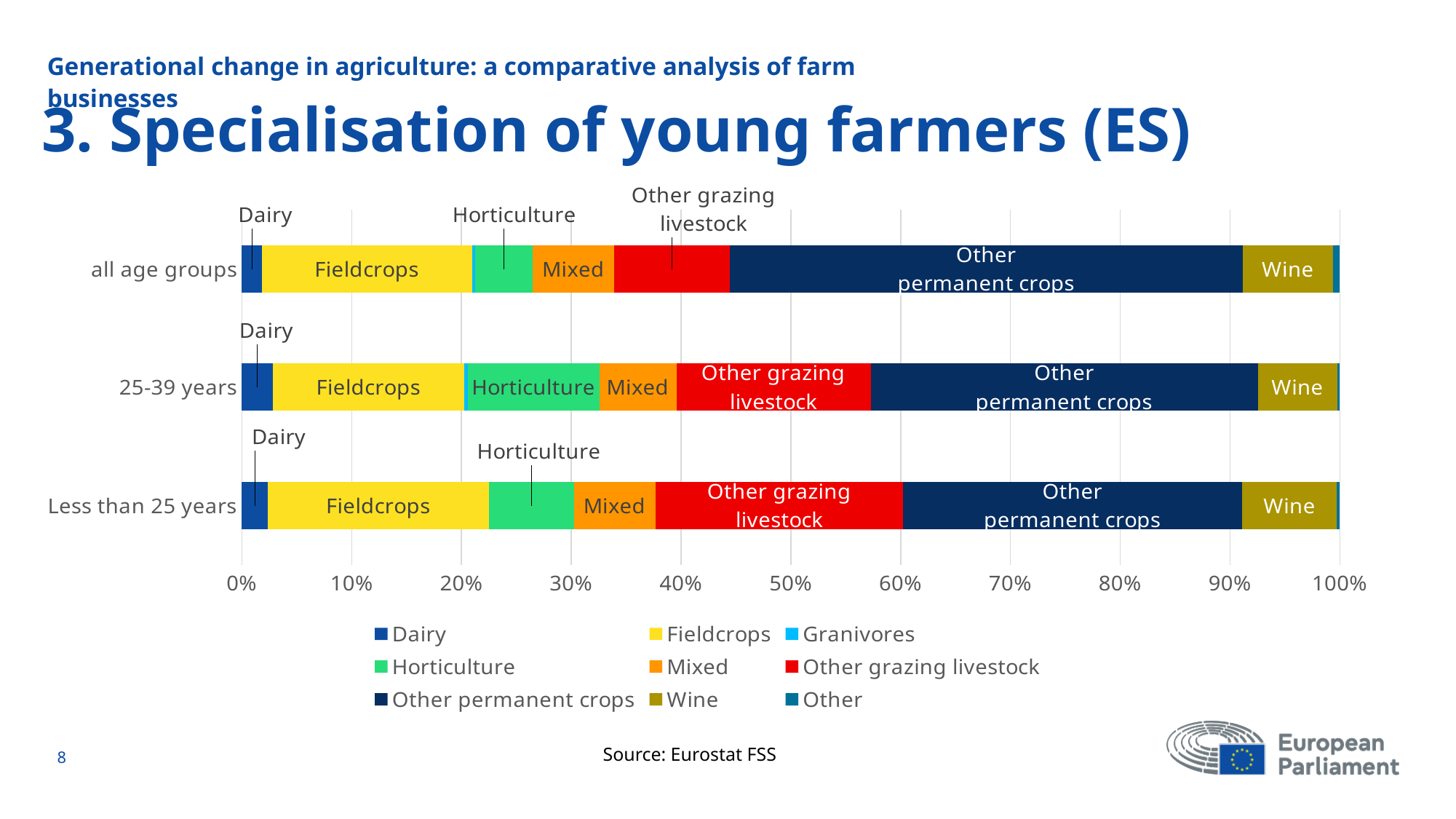
What is the source cited below the chart? Eurostat FSS How many series does the chart legend list? 9 What kind of chart is shown on the slide? Stacked bar chart Is the share of Other grazing livestock for all age groups greater or less than 20%? less Is the share of Fieldcrops for Less than 25 years greater or less than 30%? less Is the share of Other permanent crops for all age groups greater or less than 40%? greater How many age-group categories are plotted on the chart? 3 Which has a larger share of Other permanent crops: all age groups or Less than 25 years? all age groups Which has a larger share of Other grazing livestock: Less than 25 years or all age groups? Less than 25 years Which has a larger share of Horticulture: 25-39 years or all age groups? 25-39 years